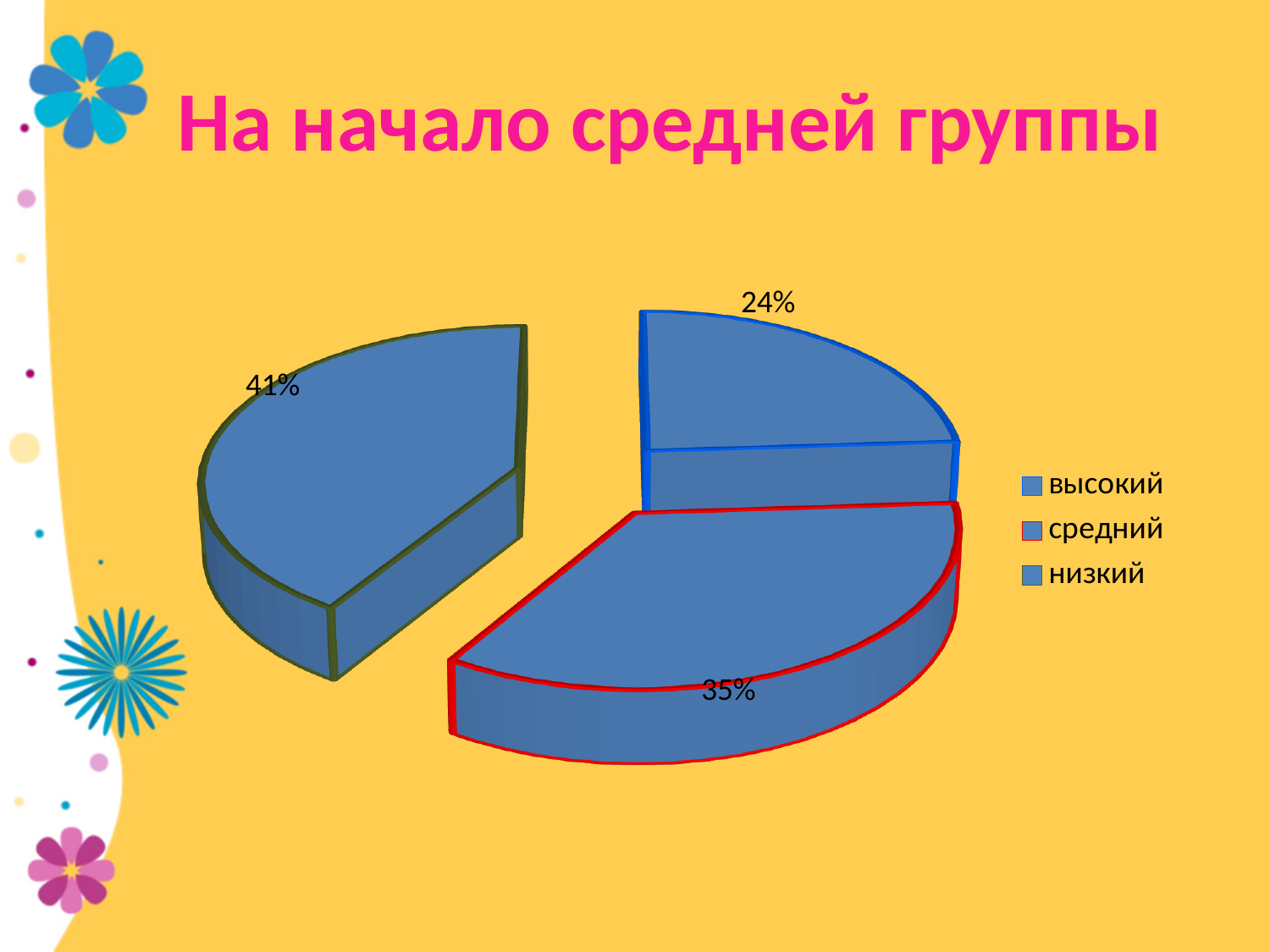
Which is larger, the 'средний' slice or the 'высокий' slice? средний Which category has the smallest share of the pie? высокий Which category has the largest share of the pie? низкий How many slices does the pie chart have? 3 What is the difference in percentage points between the 'низкий' and 'высокий' slices? 17 What percentage is shown for the 'средний' slice? 35% What kind of chart is shown on the slide? pie chart How many entries does the legend list? 3 What percentage is shown for the 'низкий' slice? 41% What percentage is shown for the 'высокий' slice? 24% What is the difference in percentage points between the 'низкий' and 'средний' slices? 6 What is the title of the chart on the slide? На начало средней группы